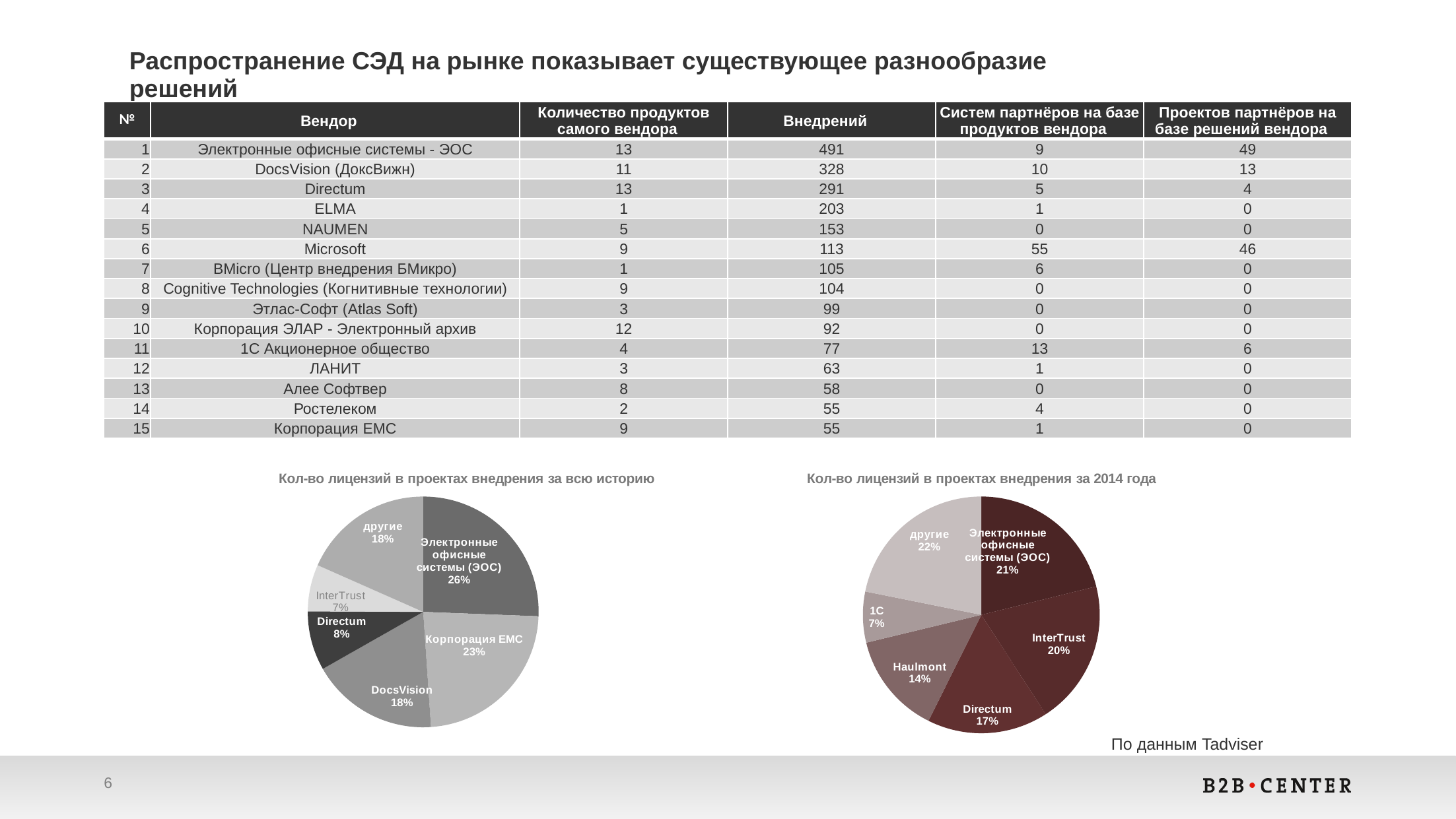
What kind of chart is the left chart titled "Кол-во лицензий в проектах внедрения за всю историю"? pie chart In the left pie chart (за всю историю), what share does Корпорация EMC have? 23% In the right pie chart (за 2014 года), what share does Haulmont have? 14% What is the title of the right pie chart? Кол-во лицензий в проектах внедрения за 2014 года In the right pie chart (за 2014 года), which is larger: Directum or Haulmont? Directum In the left pie chart (за всю историю), what is the difference in percentage points between Электронные офисные системы (ЭОС) and Корпорация EMC? 3 In the left pie chart (за всю историю), which slice is the largest? Электронные офисные системы (ЭОС) In the right pie chart (за 2014 года), what share does InterTrust have? 20% In the left pie chart (за всю историю), how many slices are there? 6 In the left pie chart (за всю историю), which slice is the smallest? InterTrust In the right pie chart (за 2014 года), which slice is the smallest? 1C